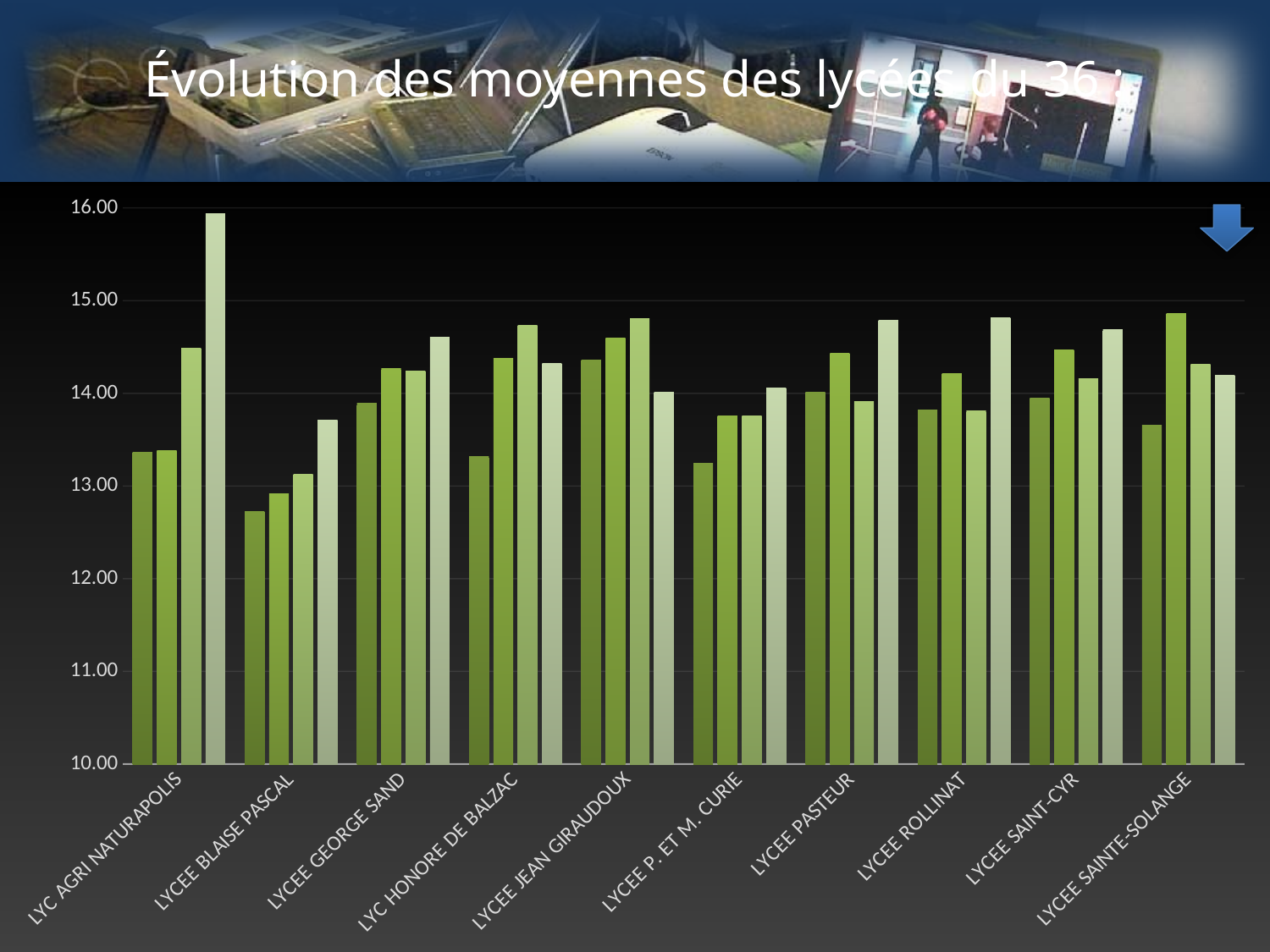
Is the tallest bar for LYC AGRI NATURAPOLIS greater or less than 15.00? greater Is the leftmost bar for LYCEE P. ET M. CURIE greater or less than 14.00? less Which lycée has the single tallest bar in the chart? LYC AGRI NATURAPOLIS Which lycée has the single lowest bar in the chart? LYCEE BLAISE PASCAL What is the lowest value shown on the chart's vertical axis? 10.00 What is the title of the slide containing the chart? Évolution des moyennes des lycées du 36 : Is the lowest bar for LYCEE BLAISE PASCAL greater or less than 13.00? less Which is larger: the tallest bar for LYC AGRI NATURAPOLIS or the tallest bar for LYCEE BLAISE PASCAL? LYC AGRI NATURAPOLIS What kind of chart is shown on the slide? bar chart How many lycées (categories) are shown on the x axis of the chart? 10